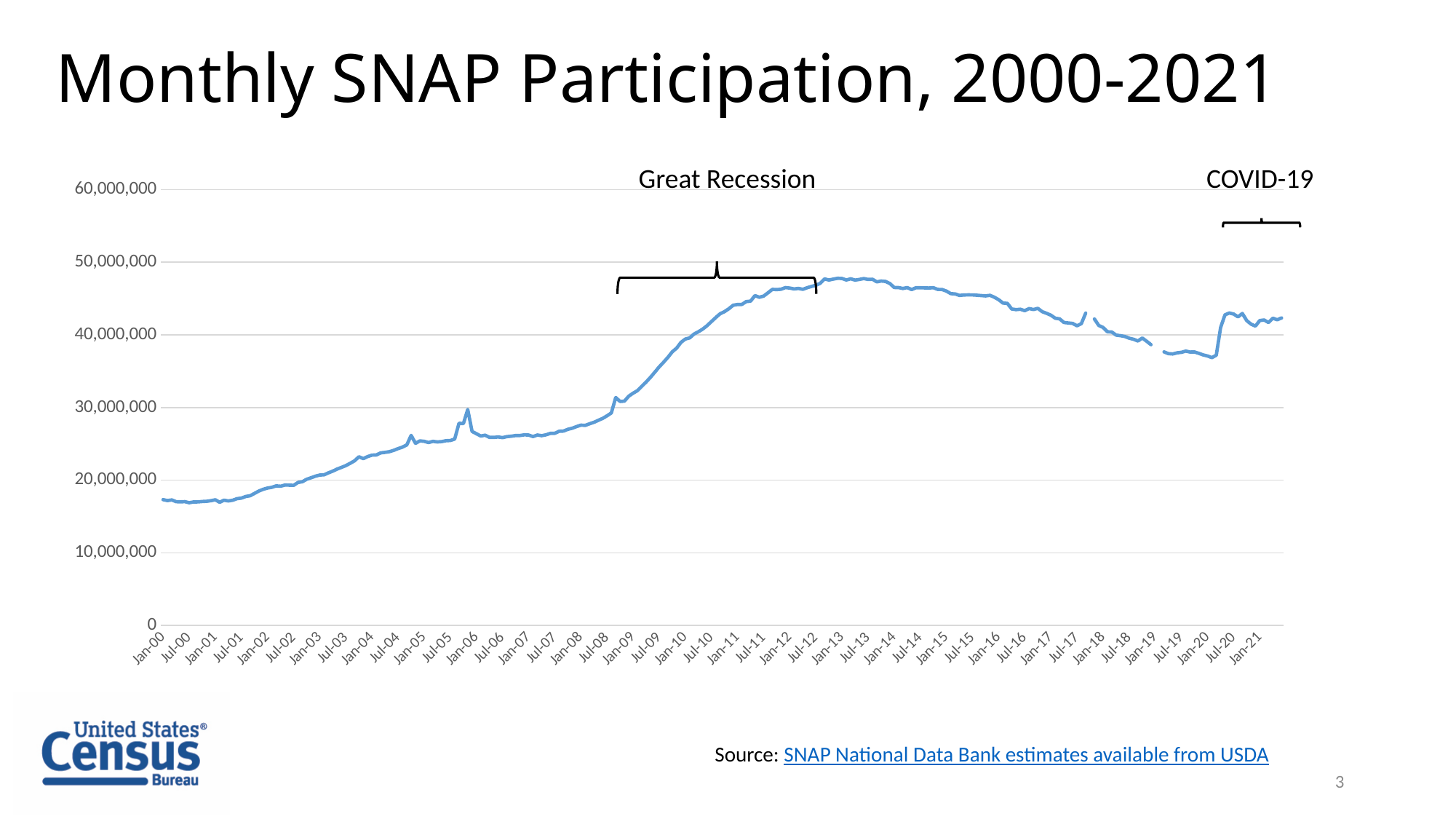
Which two events are annotated with brackets above the line? Great Recession and COVID-19 What kind of chart is shown on the slide? line chart Is the value at Jul-20 greater or less than 40,000,000? greater How many lines are plotted on the chart? 1 What is the title of the slide's chart? Monthly SNAP Participation, 2000-2021 Which is larger, the value at Jan-20 or the value at Jul-20? Jul-20 Is the value at Jan-20 greater or less than 40,000,000? less Is the value at Jan-00 greater or less than 20,000,000? less Does the line generally rise or fall between Jan-00 and Jan-13? rise Does the line generally rise or fall between Jan-13 and Jan-19? fall